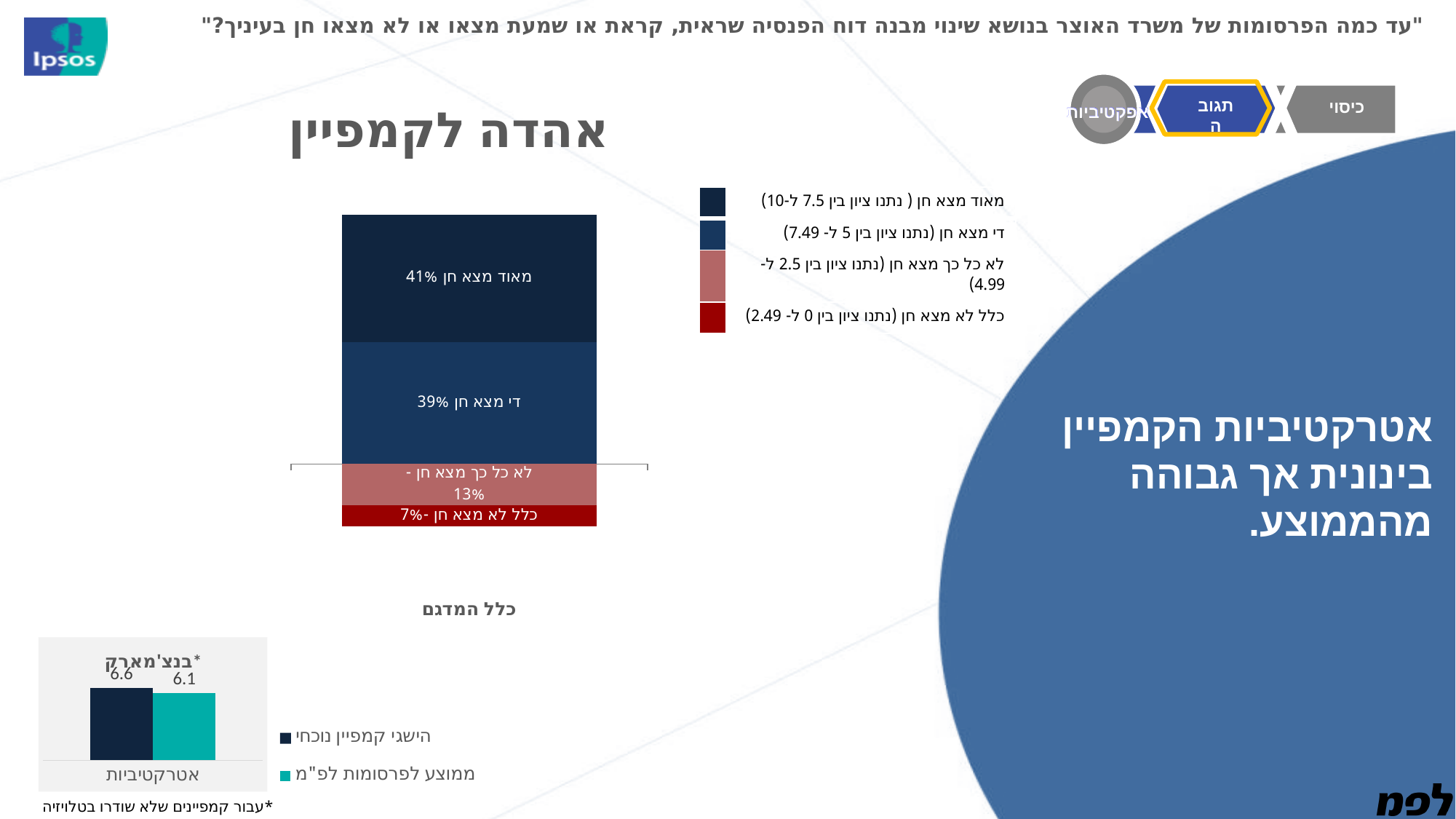
In the small benchmark chart at the bottom left ("בנצ'מארק"), what is the value for "הישגי קמפיין נוכחי"? 6.6 In the small benchmark chart at the bottom left ("בנצ'מארק"), what is the value for "ממוצע לפרסומות לפ"מ"? 6.1 In the stacked bar chart titled "אהדה לקמפיין", what percentage is shown for "כלל לא מצא חן"? 7% In the stacked bar chart titled "אהדה לקמפיין", what is the difference between the "מאוד מצא חן" and "לא כל כך מצא חן" percentages? 28% In the small benchmark chart at the bottom left ("בנצ'מארק"), what is the difference between the two bars? 0.5 In the stacked bar chart titled "אהדה לקמפיין", how many segments make up the bar? 4 In the stacked bar chart titled "אהדה לקמפיין", which segment has the smallest share? כלל לא מצא חן In the stacked bar chart titled "אהדה לקמפיין", what percentage is shown for "מאוד מצא חן"? 41% In the small benchmark chart at the bottom left ("בנצ'מארק"), how many series does the legend list? 2 In the stacked bar chart titled "אהדה לקמפיין", which segment has the largest share? מאוד מצא חן In the stacked bar chart titled "אהדה לקמפיין", what percentage is shown for "די מצא חן"? 39% In the stacked bar chart titled "אהדה לקמפיין", what percentage is shown for "לא כל כך מצא חן"? 13%